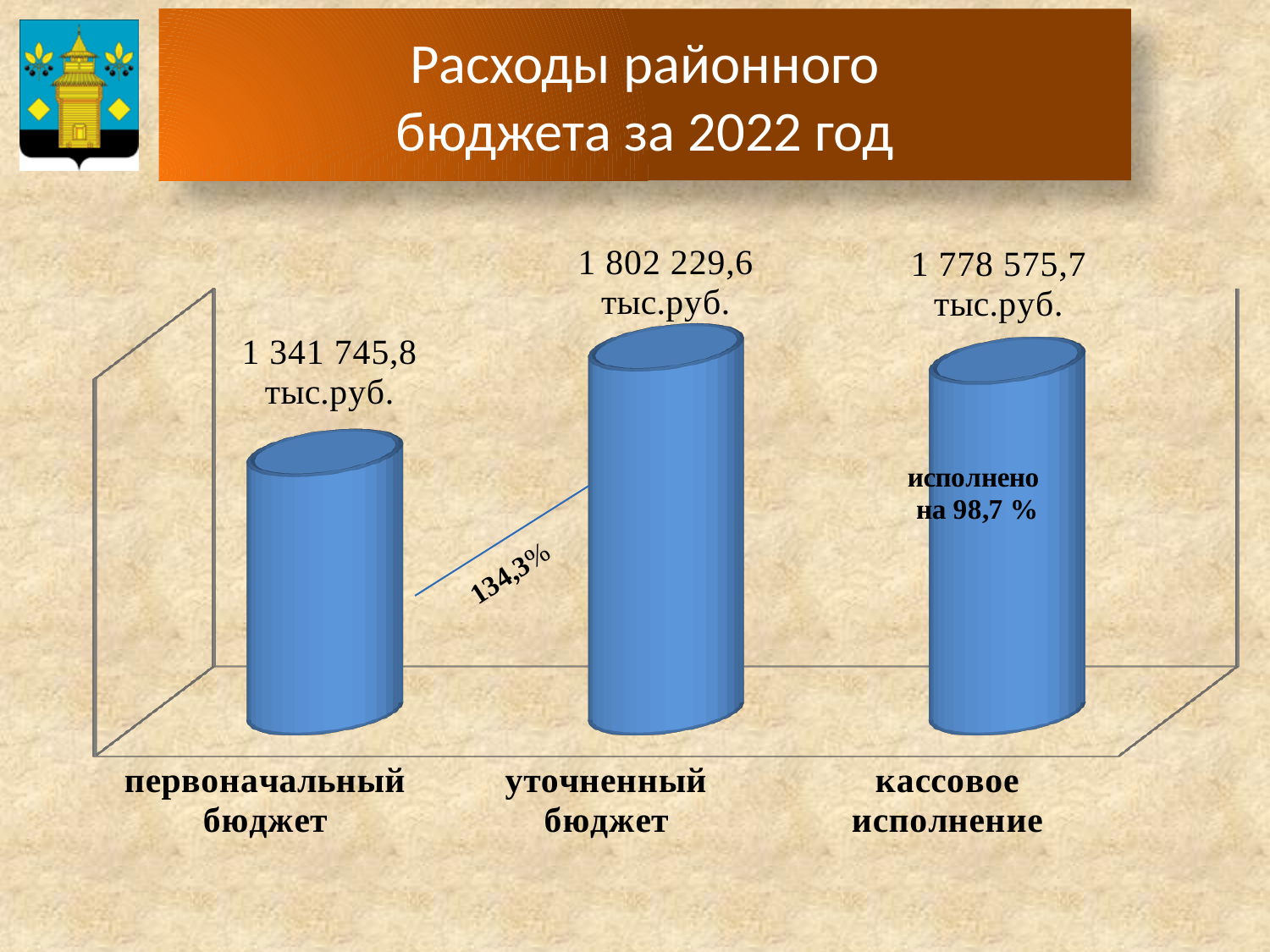
Which category has the highest value? уточненный бюджет What is the difference between уточненный бюджет and первоначальный бюджет? 460 483,8 тыс.руб. What execution percentage is written on the кассовое исполнение bar? исполнено на 98,7 % What percentage is written on the line connecting первоначальный бюджет and уточненный бюджет? 134,3% Which category has the lowest value? первоначальный бюджет What kind of chart is shown on the slide? bar chart What is the value shown for уточненный бюджет? 1 802 229,6 тыс.руб. What is the value shown for первоначальный бюджет? 1 341 745,8 тыс.руб. Which is larger, кассовое исполнение or первоначальный бюджет? кассовое исполнение How many categories are shown in the chart? 3 What is the value shown for кассовое исполнение? 1 778 575,7 тыс.руб. What is the difference between уточненный бюджет and кассовое исполнение? 23 653,9 тыс.руб.